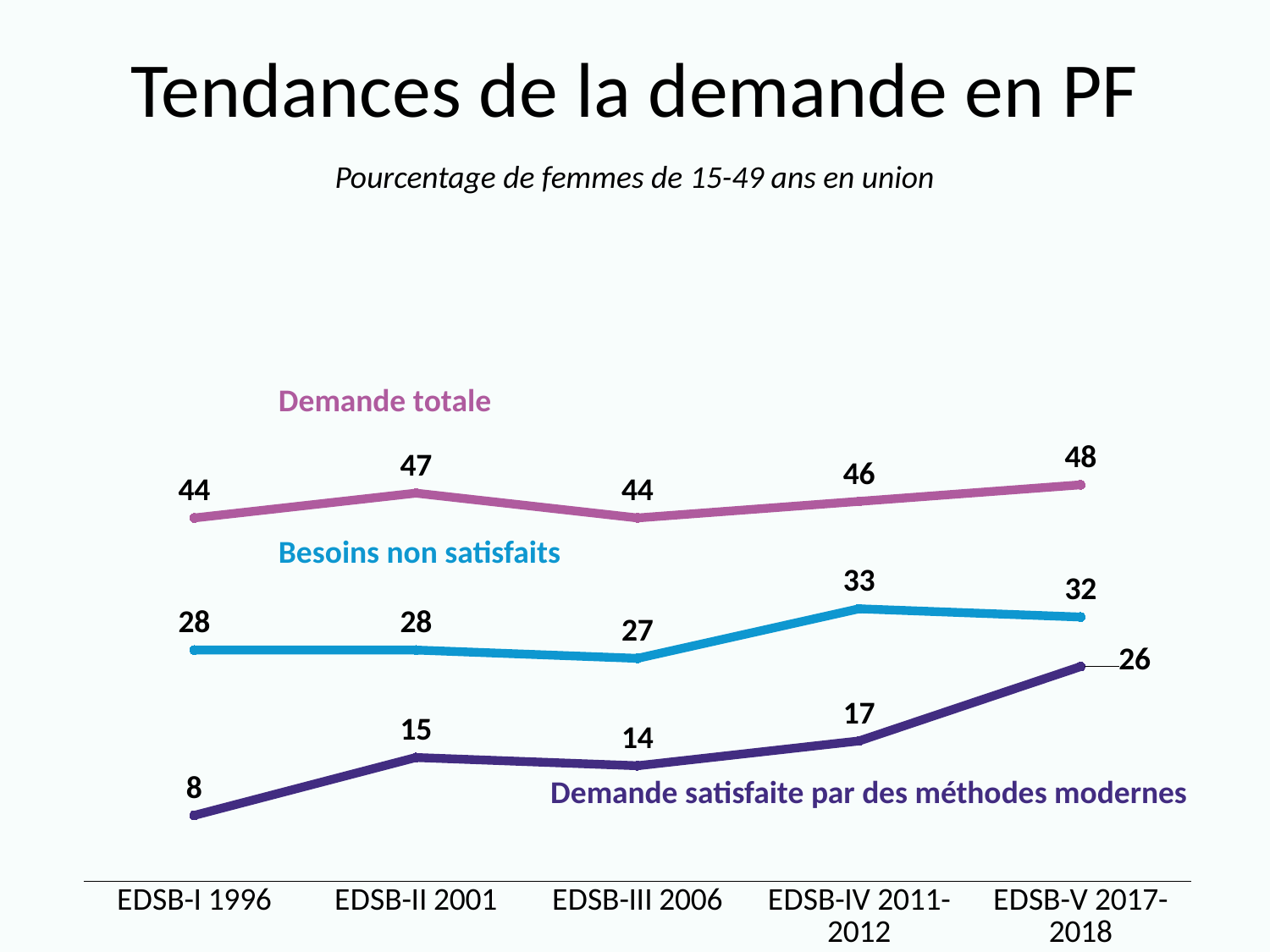
In which survey is Besoins non satisfaits lowest? EDSB-III 2006 What is the difference between Demande totale and Besoins non satisfaits for EDSB-V 2017-2018? 16 What is the subtitle shown under the chart title? Pourcentage de femmes de 15-49 ans en union How many series are plotted on the chart? 3 What type of chart is shown on the slide? line chart Which is larger for EDSB-III 2006: Besoins non satisfaits or Demande satisfaite par des méthodes modernes? Besoins non satisfaits In which survey is Demande satisfaite par des méthodes modernes highest? EDSB-V 2017-2018 What is the value of Demande satisfaite par des méthodes modernes for EDSB-I 1996? 8 How many survey points are plotted on the x axis? 5 What is the value of Besoins non satisfaits for EDSB-IV 2011-2012? 33 Does Demande satisfaite par des méthodes modernes rise or fall from EDSB-I 1996 to EDSB-V 2017-2018? rise What is the value of Demande totale for EDSB-II 2001? 47